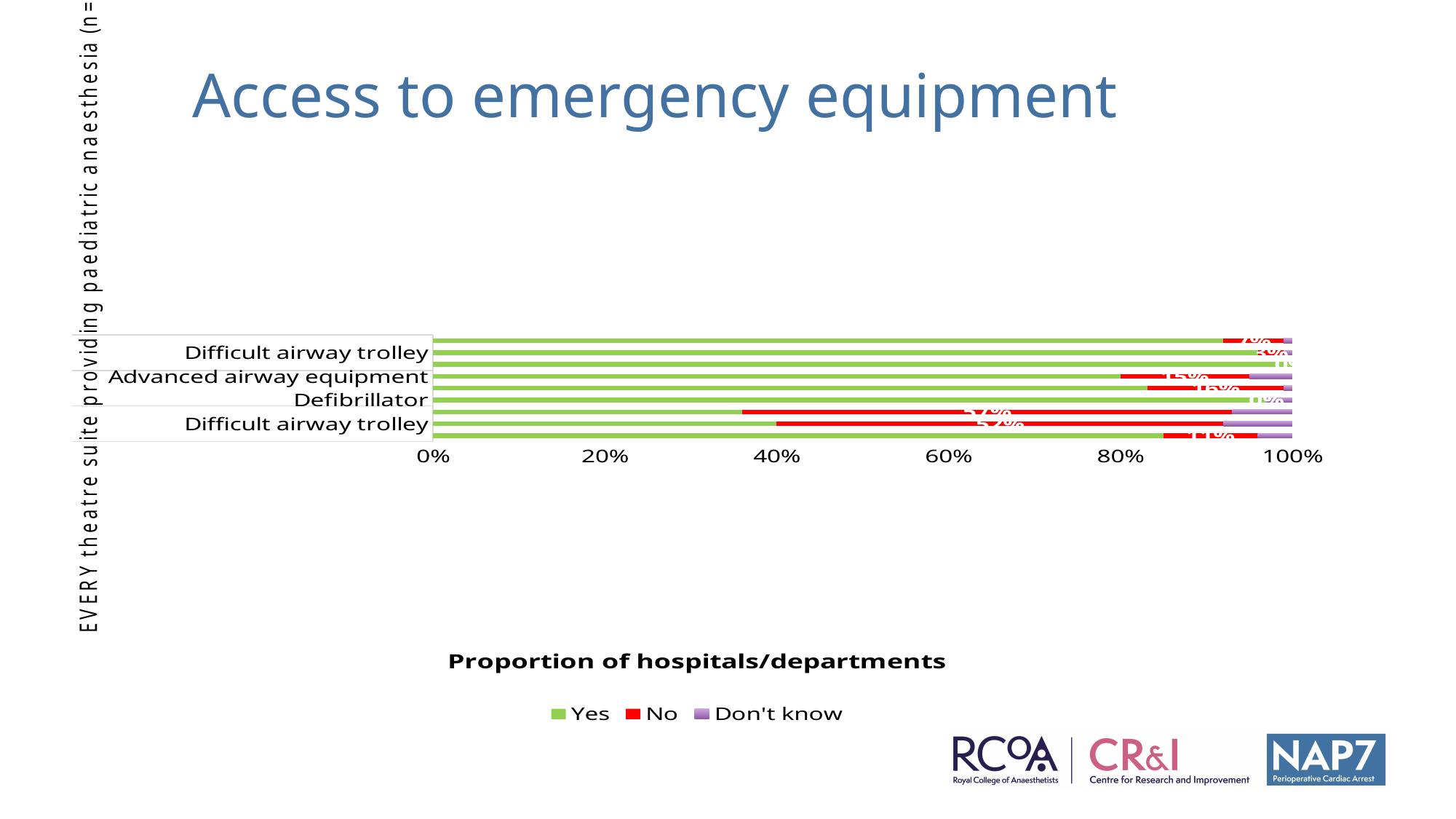
What is the title of the slide containing the chart? Access to emergency equipment Which colour represents the 'No' series in the chart? red What kind of chart is shown on the slide? stacked bar chart What is the maximum value shown on the horizontal axis? 100% How many series does the legend list? 3 What are the series named in the legend? Yes, No, Don't know What is the label on the horizontal axis of the chart? Proportion of hospitals/departments